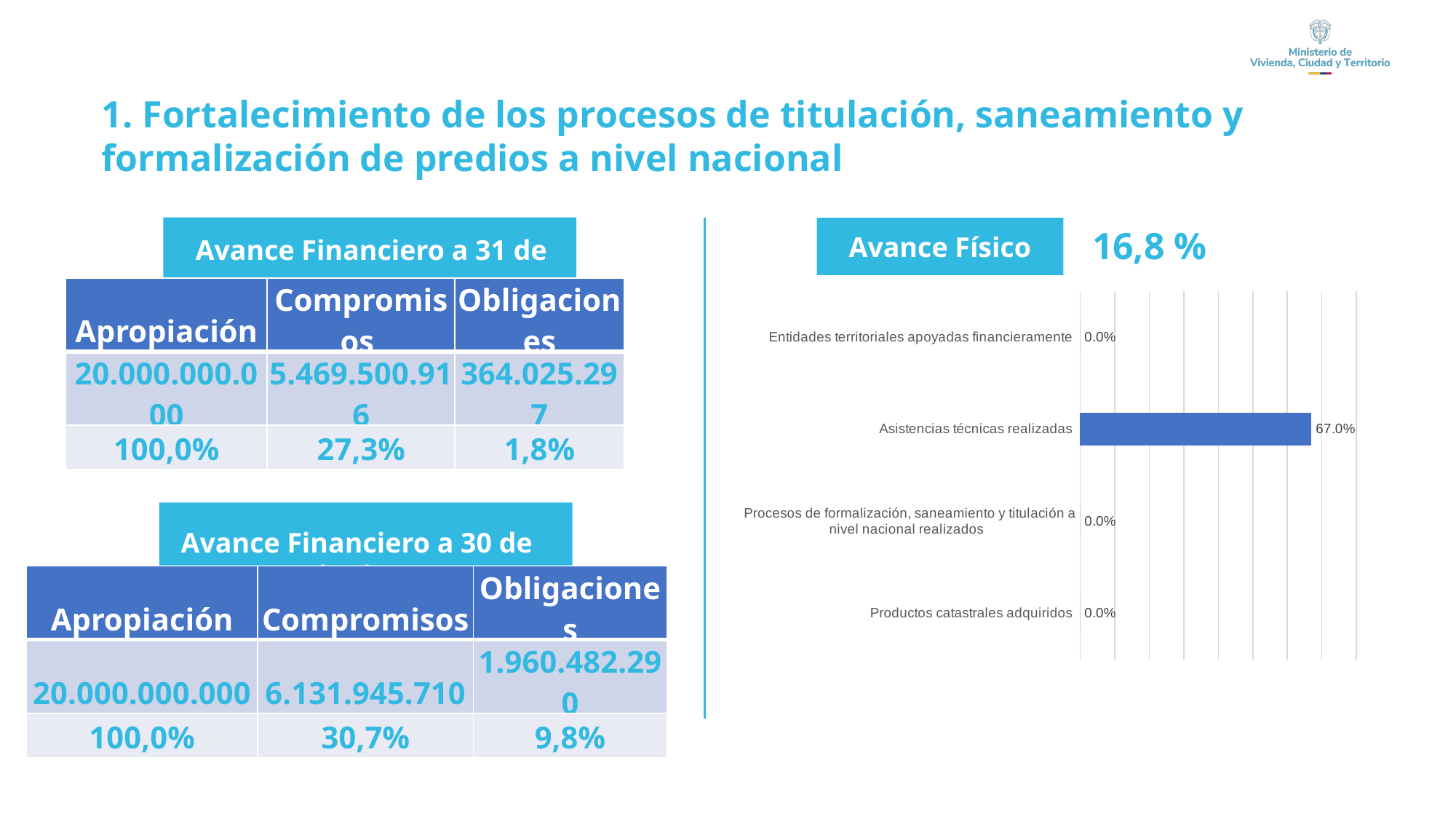
How many categories in the bar chart have a value of 0.0%? 3 In the bar chart, what is the difference between the value for "Asistencias técnicas realizadas" and the value for "Productos catastrales adquiridos"? 67.0% What is the overall "Avance Físico" percentage shown next to the chart's heading? 16,8 % In the bar chart, what is the value for "Procesos de formalización, saneamiento y titulación a nivel nacional realizados"? 0.0% In the bar chart, which is larger: the value for "Asistencias técnicas realizadas" or the value for "Entidades territoriales apoyadas financieramente"? Asistencias técnicas realizadas What colour is the bar for "Asistencias técnicas realizadas" in the bar chart? blue What kind of chart is shown on the right side of the slide under "Avance Físico"? bar chart In the bar chart, what is the value for "Entidades territoriales apoyadas financieramente"? 0.0% Which category has the highest value in the bar chart? Asistencias técnicas realizadas In the bar chart, what is the value for "Productos catastrales adquiridos"? 0.0% How many categories are plotted in the bar chart? 4 In the bar chart, what is the value for "Asistencias técnicas realizadas"? 67.0%